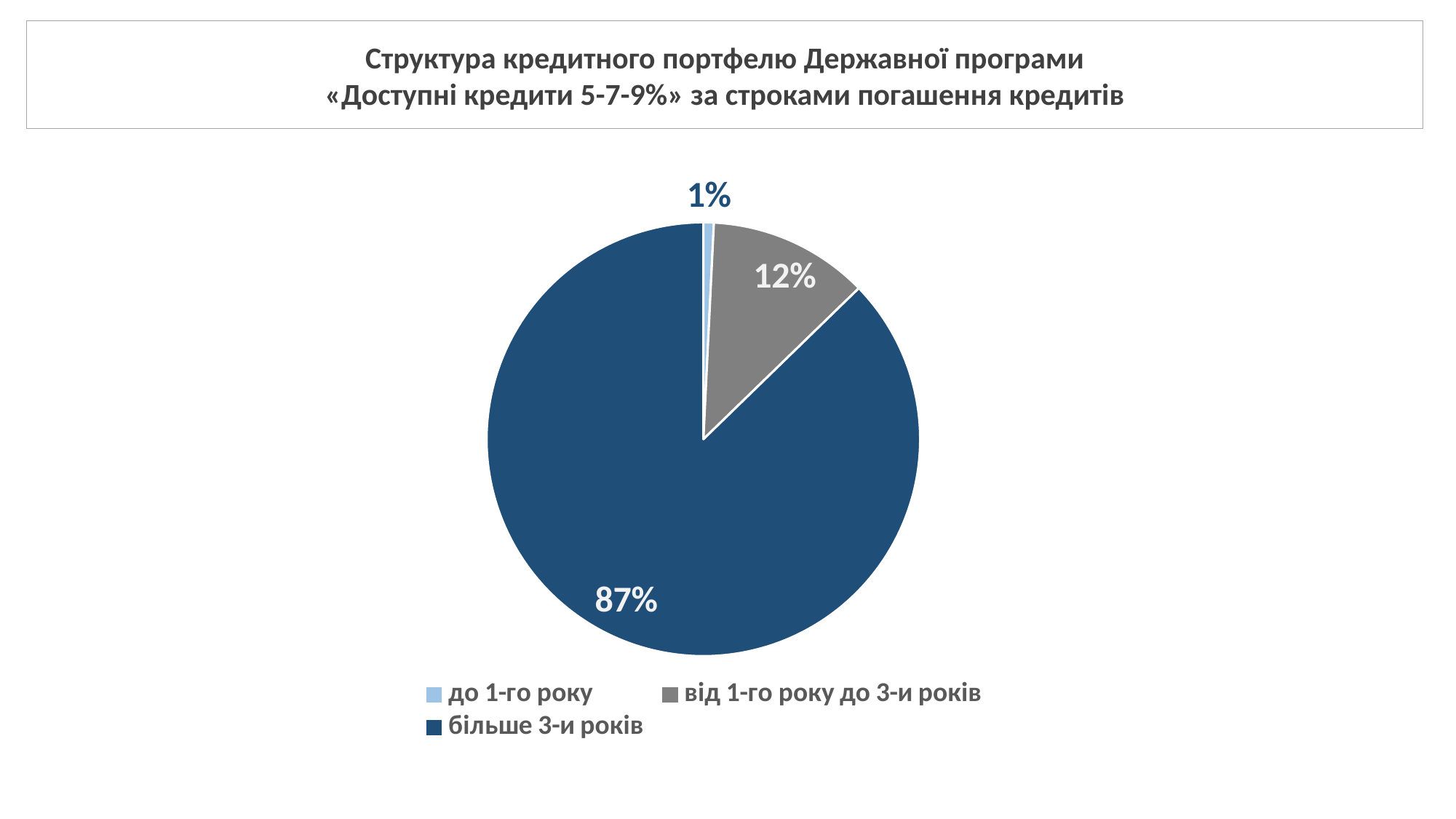
What share of the pie does the slice for «більше 3-и років» represent? 87% Which is larger: the slice for «від 1-го року до 3-и років» or the slice for «до 1-го року»? від 1-го року до 3-и років What is the title of the chart? Структура кредитного портфелю Державної програми «Доступні кредити 5-7-9%» за строками погашення кредитів What share of the pie does the slice for «до 1-го року» represent? 1% How many categories are shown in the pie chart? 3 What is the difference in percentage points between the slices for «більше 3-и років» and «від 1-го року до 3-и років»? 75 What share of the pie does the slice for «від 1-го року до 3-и років» represent? 12% Which category has the smallest slice of the pie? до 1-го року Which category has the largest slice of the pie? більше 3-и років What colour is the slice for «від 1-го року до 3-и років»? Grey What kind of chart is shown on the slide? Pie chart What is the difference in percentage points between the slices for «від 1-го року до 3-и років» and «до 1-го року»? 11